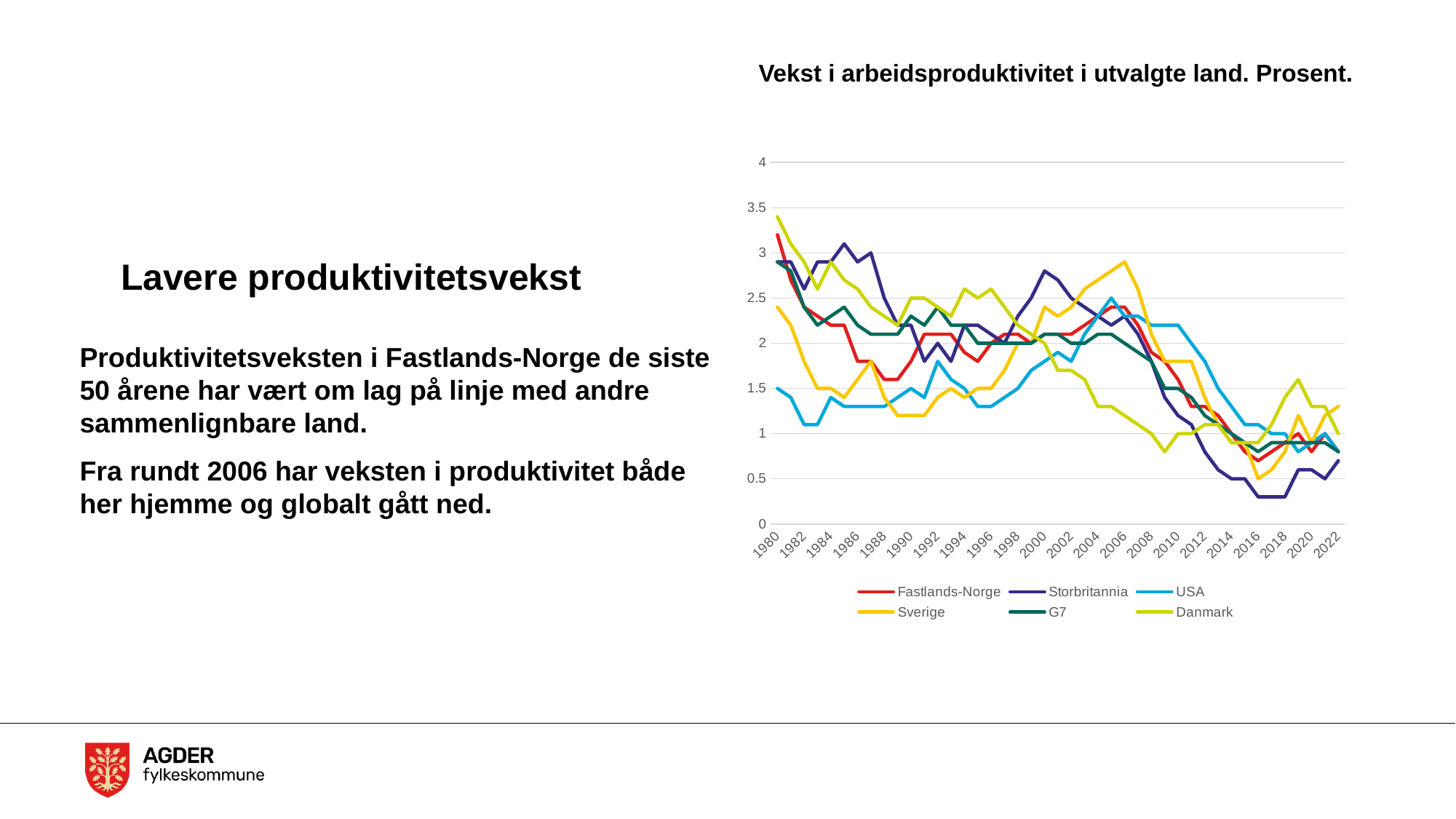
Is the value for Storbritannia in 2016 greater or less than 0.5? less Is the value for Danmark in 1980 greater or less than 3? greater What is the title of the chart? Vekst i arbeidsproduktivitet i utvalgte land. Prosent. Does the Fastlands-Norge line generally rise or fall from 1980 to 2022? fall What kind of chart is shown on the slide? line chart Is the value for USA in 1982 greater or less than 1.5? less How many series does the legend list? 6 How many year labels are shown on the x axis? 22 In 2006, which is larger: the value for Sverige or the value for Storbritannia? Sverige Which series has the highest value in 1980? Danmark Which series has the lowest value in 2016? Storbritannia